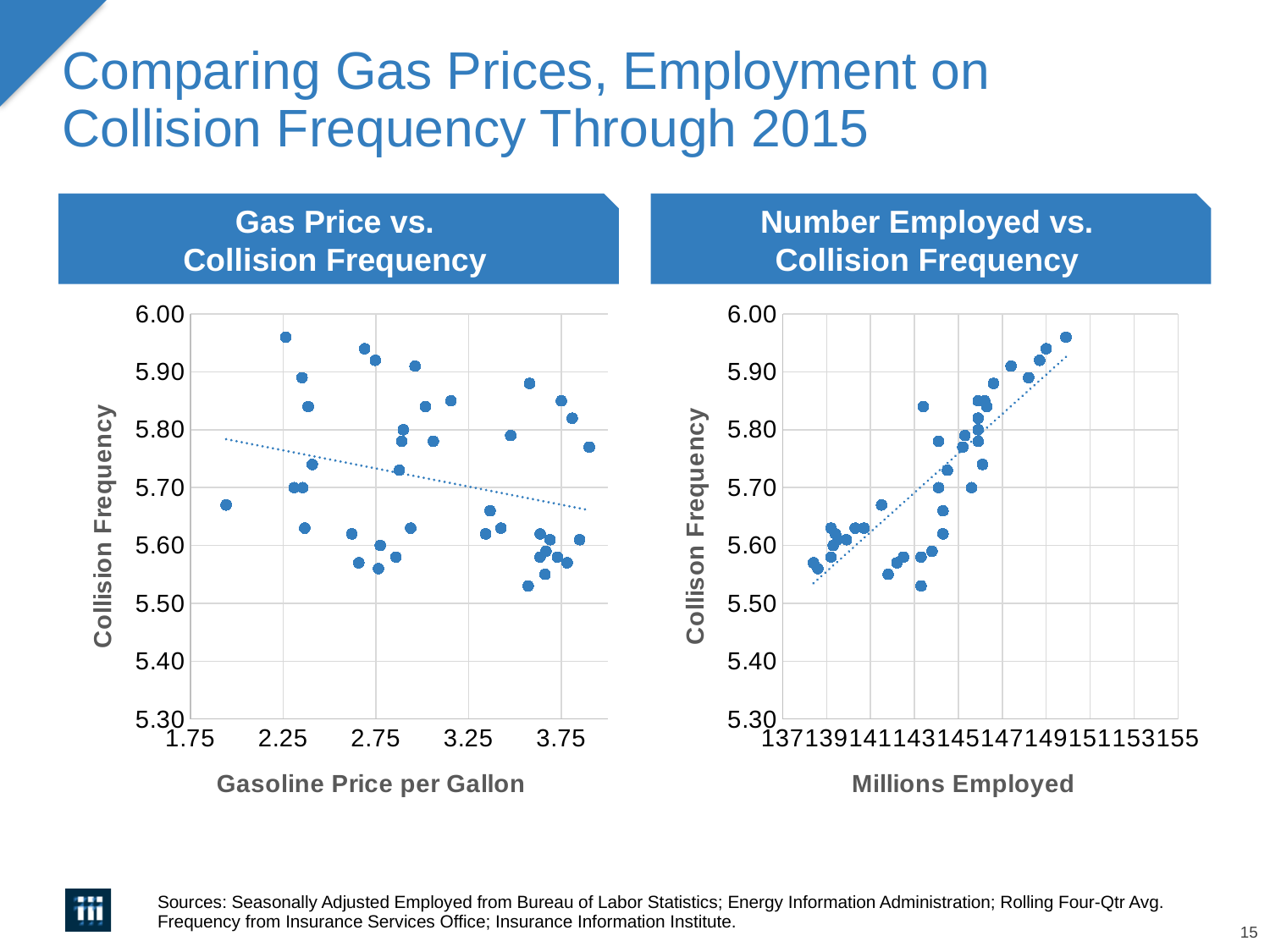
In the 'Gas Price vs. Collision Frequency' chart, is the highest plotted collision frequency greater or less than 5.90? greater In the 'Number Employed vs. Collision Frequency' chart, does the dotted trend line rise or fall as millions employed increases? Rises In the 'Gas Price vs. Collision Frequency' chart, is the collision frequency of the leftmost point (near a gas price of 1.95) greater or less than 5.60? greater In the 'Number Employed vs. Collision Frequency' chart, is the lowest plotted collision frequency greater or less than 5.60? less What kind of chart is the 'Gas Price vs. Collision Frequency' chart? Scatter chart In the 'Gas Price vs. Collision Frequency' chart, does the dotted trend line rise or fall as gasoline price increases? Falls What is the highest value shown on the x-axis of the 'Number Employed vs. Collision Frequency' chart? 155 What is the lowest value shown on the y-axis of the 'Gas Price vs. Collision Frequency' chart? 5.30 What is the x-axis label of the 'Number Employed vs. Collision Frequency' chart? Millions Employed What kind of chart is the 'Number Employed vs. Collision Frequency' chart? Scatter chart